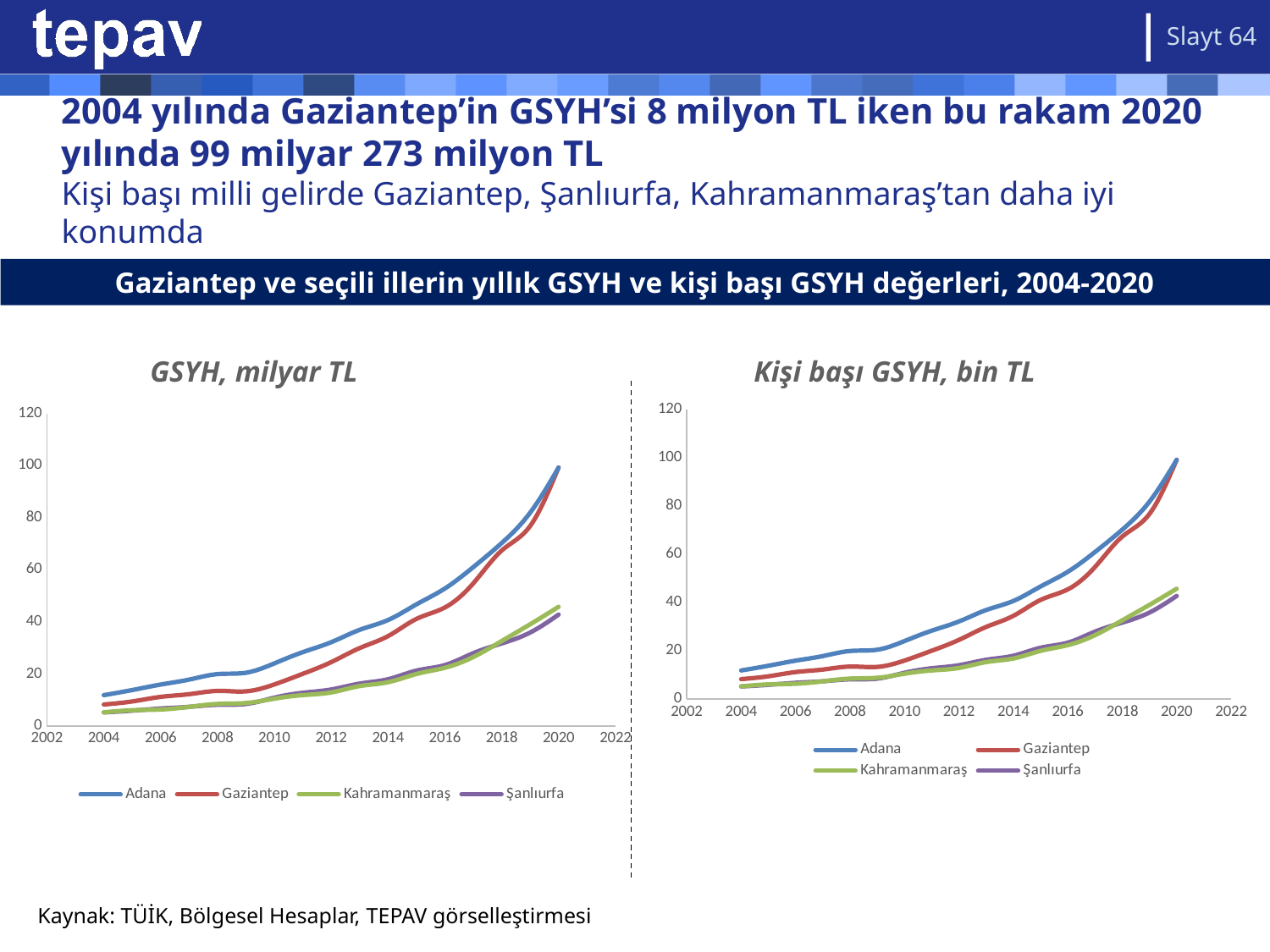
In the left chart 'GSYH, milyar TL', which is larger in 2016, Gaziantep or Şanlıurfa? Gaziantep In the left chart 'GSYH, milyar TL', does the Adana line rise or fall from 2004 to 2020? rise In the left chart 'GSYH, milyar TL', is the value for Adana in 2020 greater or less than 80? greater In the right chart 'Kişi başı GSYH, bin TL', which is larger in 2020, Adana or Kahramanmaraş? Adana What kind of chart is the right chart titled 'Kişi başı GSYH, bin TL'? line chart In the left chart 'GSYH, milyar TL', is the value for Gaziantep in 2004 greater or less than 20? less How many series does the legend of the left chart 'GSYH, milyar TL' list? 4 In the right chart 'Kişi başı GSYH, bin TL', is the value for Kahramanmaraş in 2004 greater or less than 20? less What kind of chart is the left chart titled 'GSYH, milyar TL'? line chart In the left chart 'GSYH, milyar TL', which series has the highest value in 2016? Adana Which series are listed in the legend of the right chart 'Kişi başı GSYH, bin TL'? Adana, Gaziantep, Kahramanmaraş, Şanlıurfa